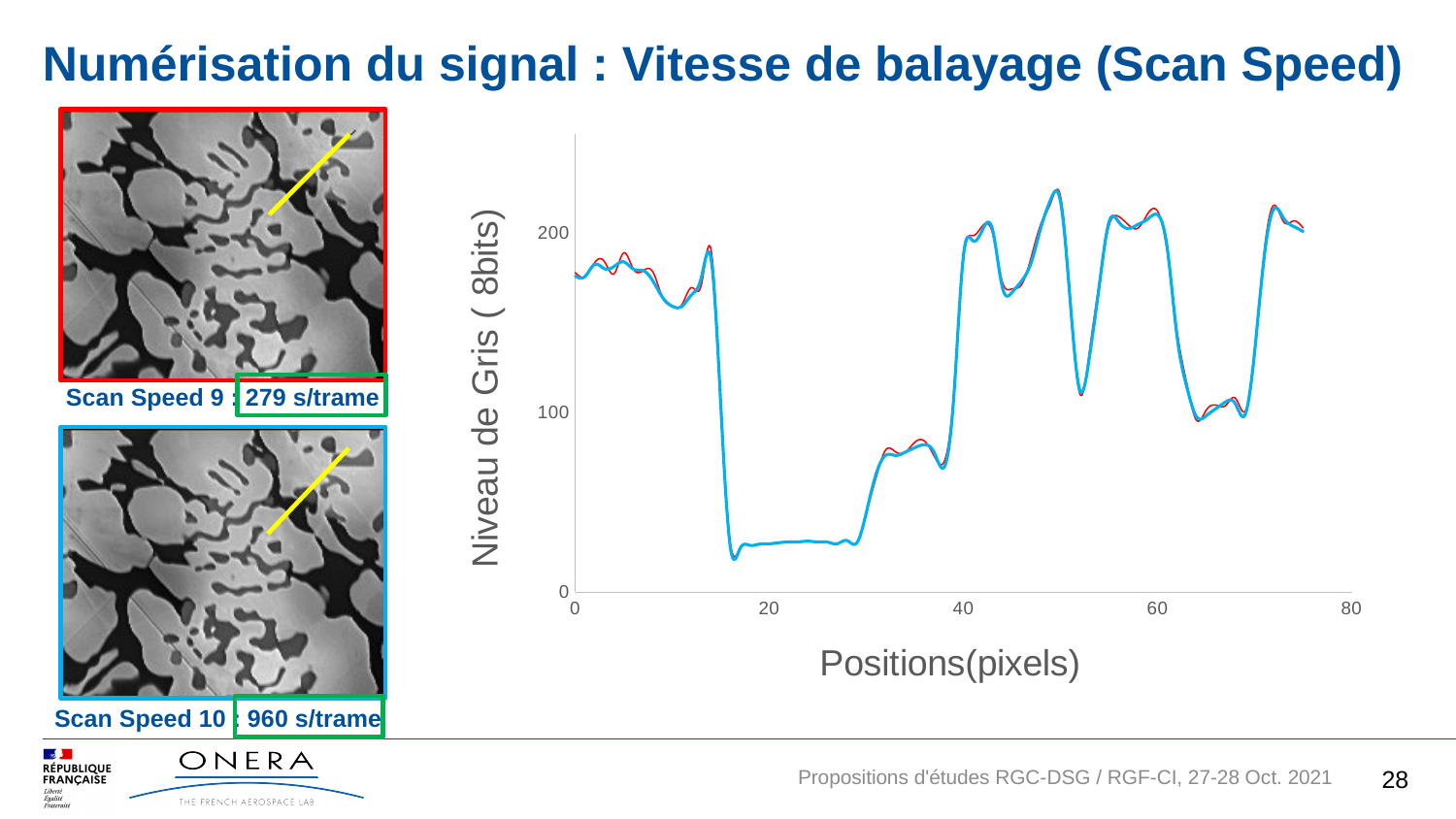
Is the value of the curves at position 0 greater or less than 100? greater Which is larger, the value of the curves at position 20 or at position 40? position 40 What is the label of the x axis of the chart? Positions(pixels) Is the value of the curves at position 65 greater or less than 200? less What kind of chart is shown on the right of the slide? line chart Is the value of the curves at position 20 greater or less than 100? less Between positions 28 and 32, do the curves rise or fall? rise Between positions 15 and 17, do the curves rise or fall? fall What is the label of the y axis of the chart? Niveau de Gris ( 8bits)